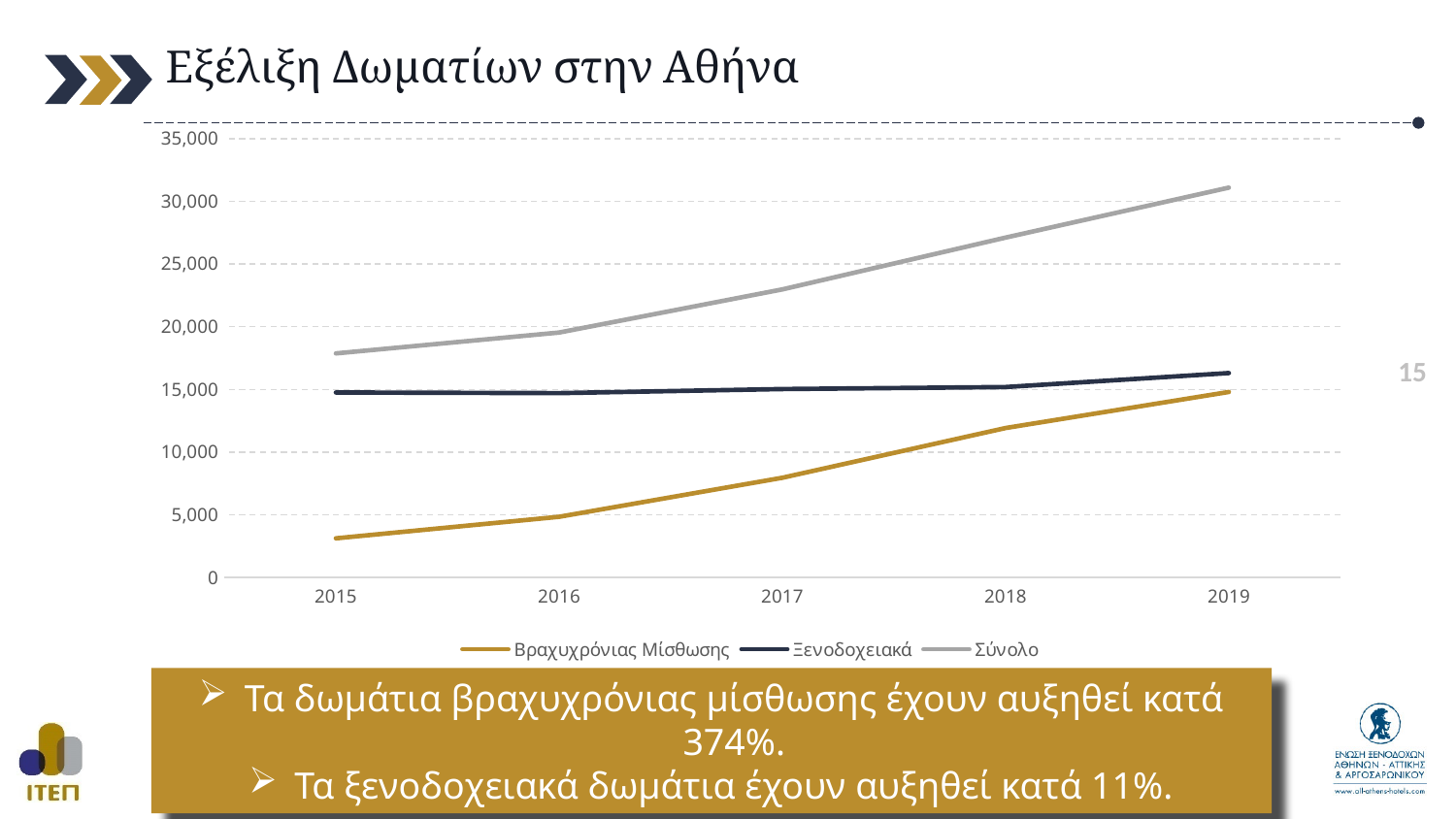
Does the Βραχυχρόνιας Μίσθωσης series rise or fall from 2015 to 2019? rise What kind of chart is shown on the slide? line chart Is the value for Σύνολο in 2019 greater or less than 30,000? greater Is the value for Σύνολο in 2015 greater or less than 20,000? less Which series is drawn in gold? Βραχυχρόνιας Μίσθωσης Which series has the lowest value in 2015? Βραχυχρόνιας Μίσθωσης What is the title of the chart? Εξέλιξη Δωματίων στην Αθήνα In 2019, which is larger: Σύνολο or Ξενοδοχειακά? Σύνολο Is the value for Βραχυχρόνιας Μίσθωσης in 2015 greater or less than 5,000? less How many years are shown on the x axis? 5 Which series has the highest value in 2019? Σύνολο How many series does the legend list? 3